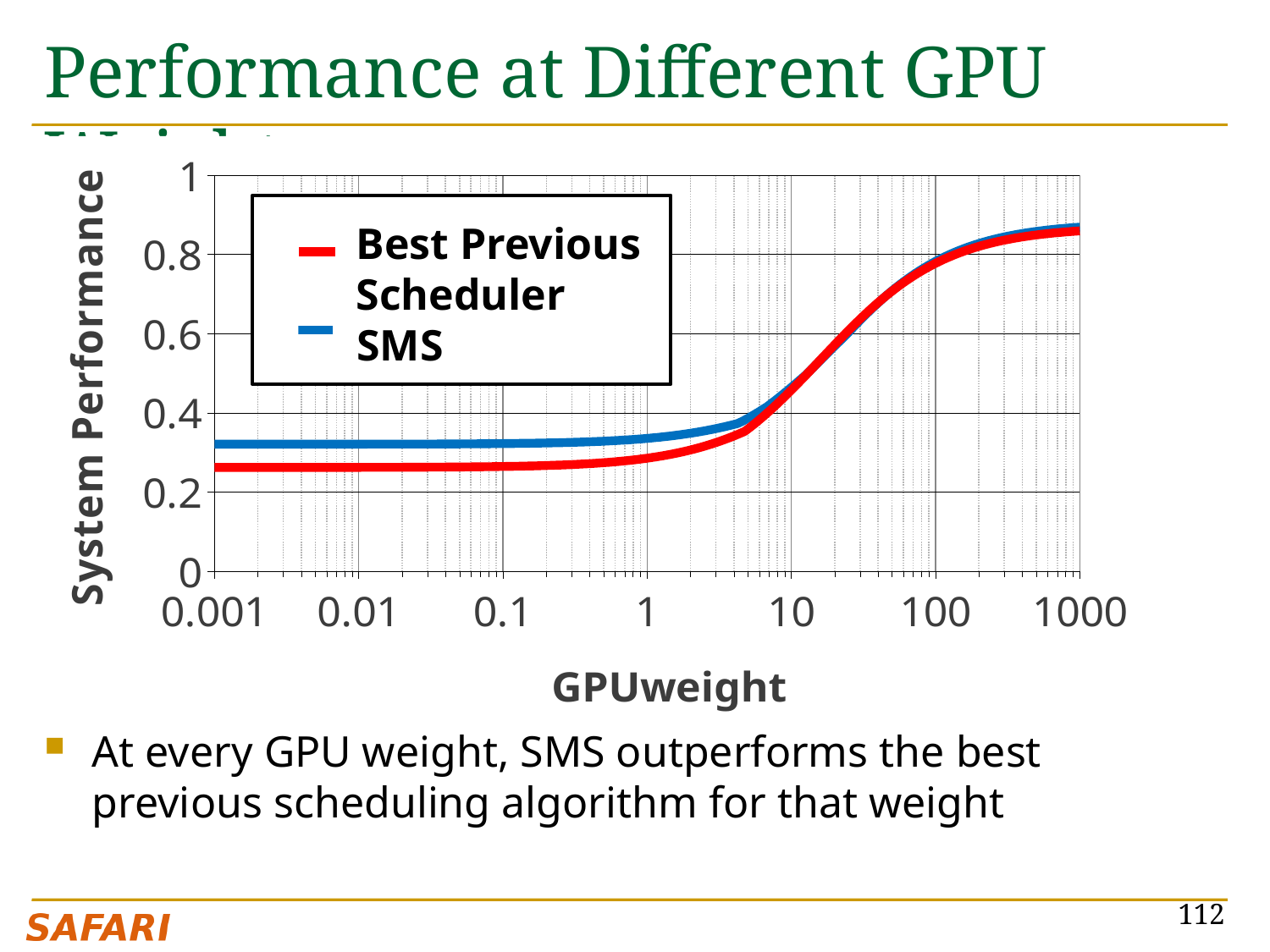
Is the value for SMS at GPUweight 0.001 greater or less than 0.4? less What kind of chart is shown on the slide? line chart Is the value for Best Previous Scheduler at GPUweight 1 greater or less than 0.4? less Is the value for SMS at GPUweight 1000 greater or less than 0.8? greater At GPUweight 0.001, which series has the higher System Performance, SMS or Best Previous Scheduler? SMS Does System Performance rise or fall as GPUweight increases from 1 to 1000? rise Which series is drawn in red? Best Previous Scheduler What is the label of the x axis? GPUweight How many series does the legend list? 2